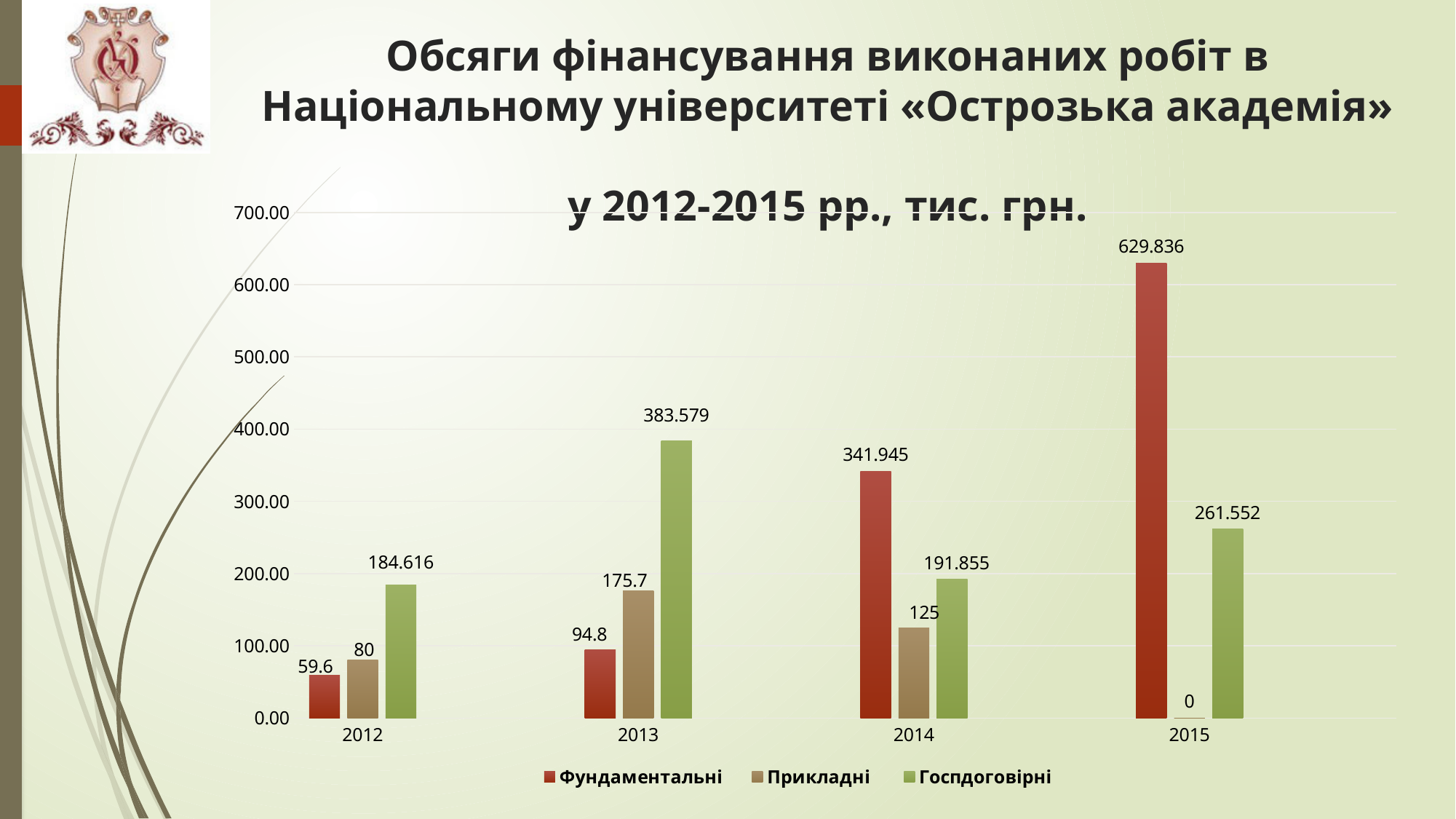
How many years are shown on the x axis? 4 What is the value for Фундаментальні in 2015? 629.836 How many series does the legend list? 3 Which is larger in 2013: Прикладні or Госпдоговірні? Госпдоговірні In which year is the Фундаментальні value highest? 2015 What is the value for Прикладні in 2014? 125 What is the value for Госпдоговірні in 2013? 383.579 In which year is the Госпдоговірні value lowest? 2012 What is the difference between the Фундаментальні values in 2015 and 2014? 287.891 What is the value for Прикладні in 2015? 0 What kind of chart is shown on the slide? Bar chart Do the Фундаментальні values rise or fall from 2012 to 2015? Rise